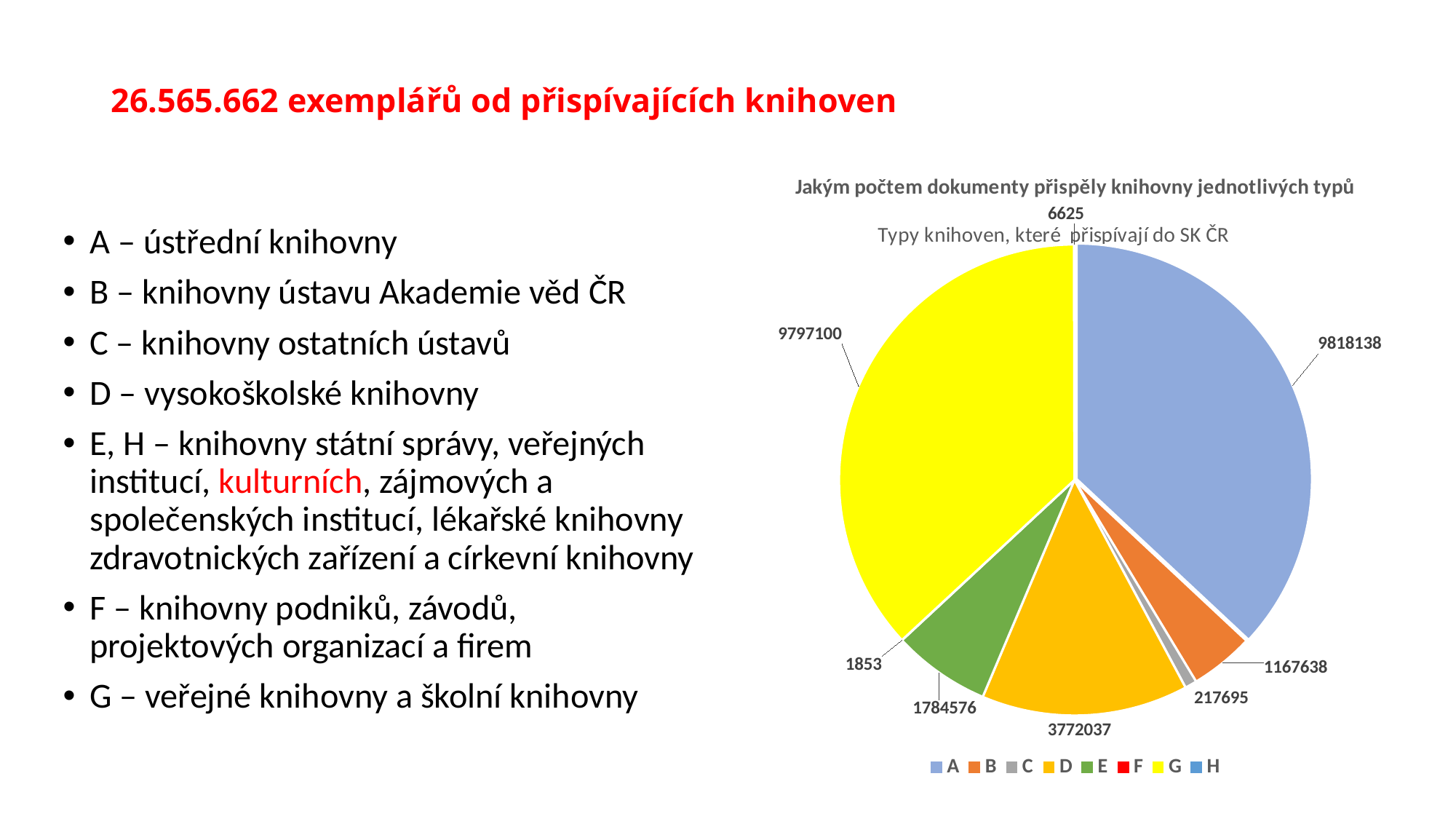
What colour is the slice for category G? Yellow What is the value for category G in the pie chart? 9797100 How many categories does the legend of the pie chart list? 8 What is the value for category F in the pie chart? 1853 What is the difference between the values for D and E? 1987461 What is the value for category D in the pie chart? 3772037 Which is larger, the value for E or the value for B? E Which category has the smallest value in the pie chart? F What type of chart is shown on the slide? Pie chart Which category has the largest value in the pie chart? A What is the value for category A in the pie chart? 9818138 What is the difference between the values for B and C? 949943